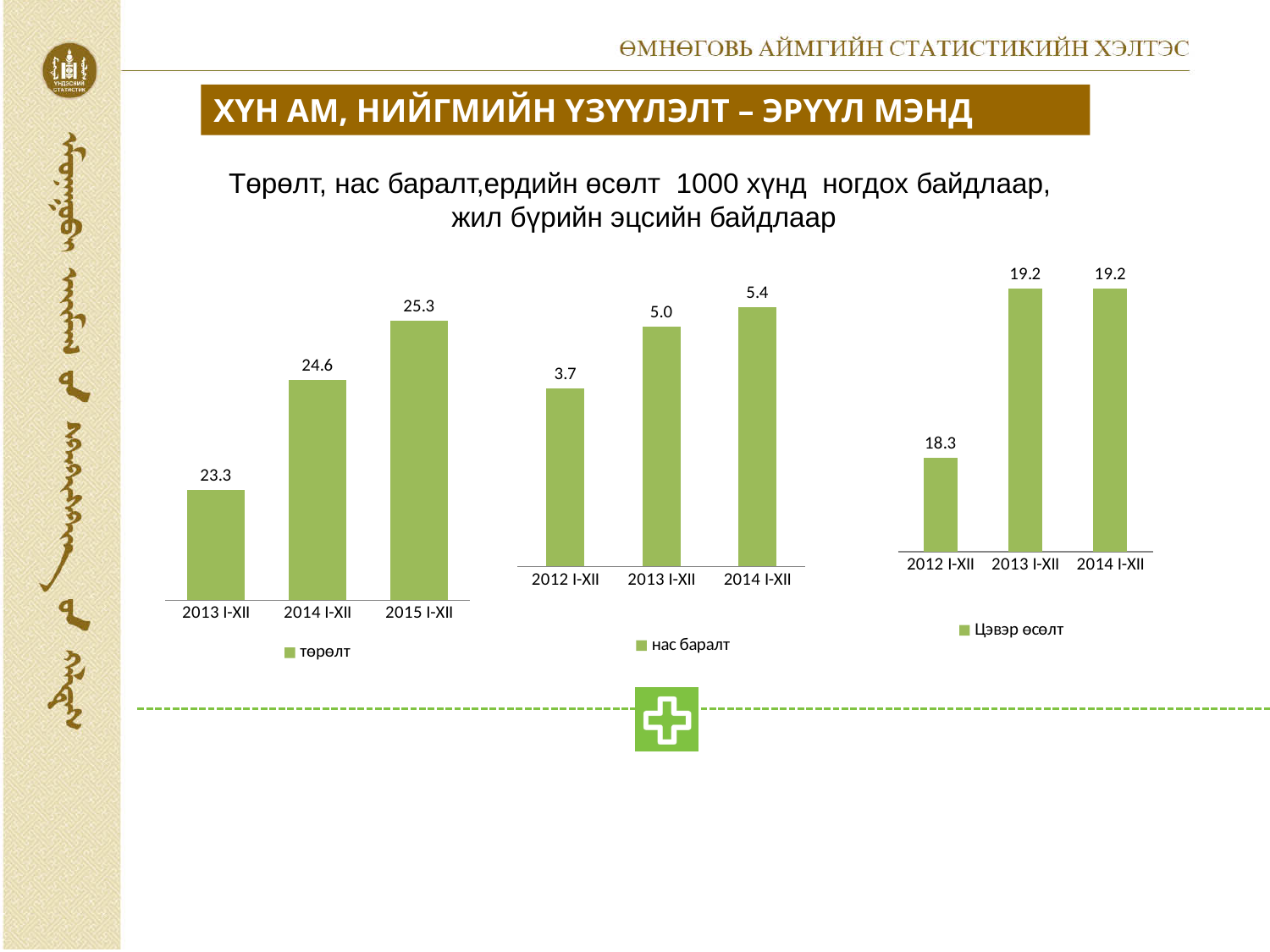
In the left chart (legend "төрөлт"), what is the difference between the values for 2015 I-XII and 2013 I-XII? 2.0 In the left chart (legend "төрөлт"), do the values rise or fall from 2013 I-XII to 2015 I-XII? rise In the left chart (legend "төрөлт"), what is the value for 2015 I-XII? 25.3 In the middle chart (legend "нас баралт"), what is the value for 2012 I-XII? 3.7 What is the legend entry of the right chart? Цэвэр өсөлт What kind of chart is the middle chart (legend "нас баралт")? bar chart In the right chart (legend "Цэвэр өсөлт"), what is the value for 2012 I-XII? 18.3 In the right chart (legend "Цэвэр өсөлт"), which is larger, the value for 2013 I-XII or 2012 I-XII? 2013 I-XII In the right chart (legend "Цэвэр өсөлт"), how many bars are plotted? 3 In the middle chart (legend "нас баралт"), what is the difference between the values for 2013 I-XII and 2012 I-XII? 1.3 In the middle chart (legend "нас баралт"), which period has the highest value? 2014 I-XII In the left chart (legend "төрөлт"), which period has the lowest value? 2013 I-XII